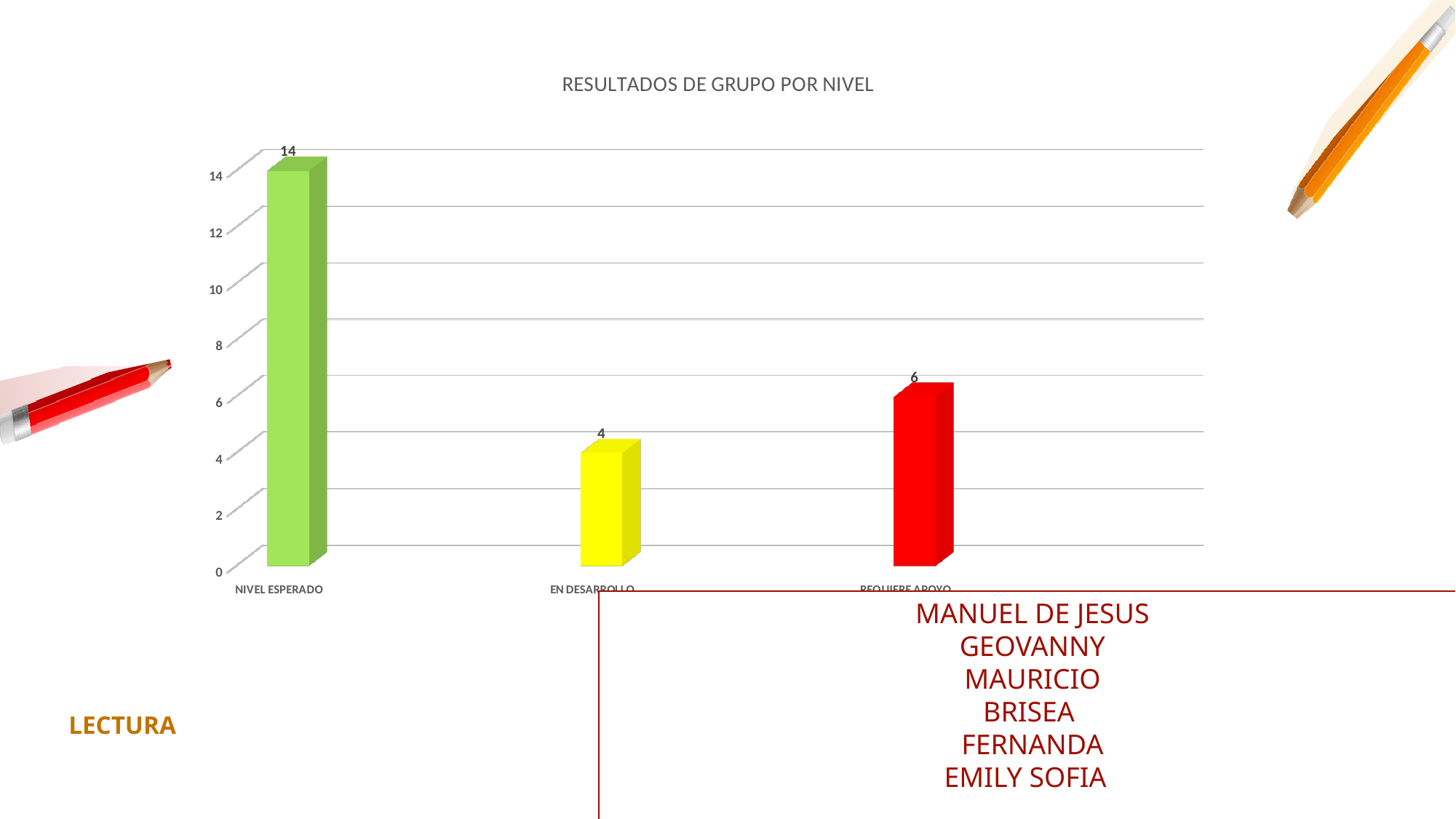
Is the value for NIVEL ESPERADO greater or less than 10? greater What is the title of the chart? RESULTADOS DE GRUPO POR NIVEL What is the value for EN DESARROLLO? 4 What is the difference between the values for NIVEL ESPERADO and REQUIERE APOYO? 8 Which is larger, the value for EN DESARROLLO or the value for REQUIERE APOYO? REQUIERE APOYO How many categories are shown in the chart? 3 What is the difference between the values for REQUIERE APOYO and EN DESARROLLO? 2 What is the value for NIVEL ESPERADO? 14 Which category has the lowest value? EN DESARROLLO Which category has the highest value? NIVEL ESPERADO What kind of chart is shown on the slide? bar chart What is the value for REQUIERE APOYO? 6